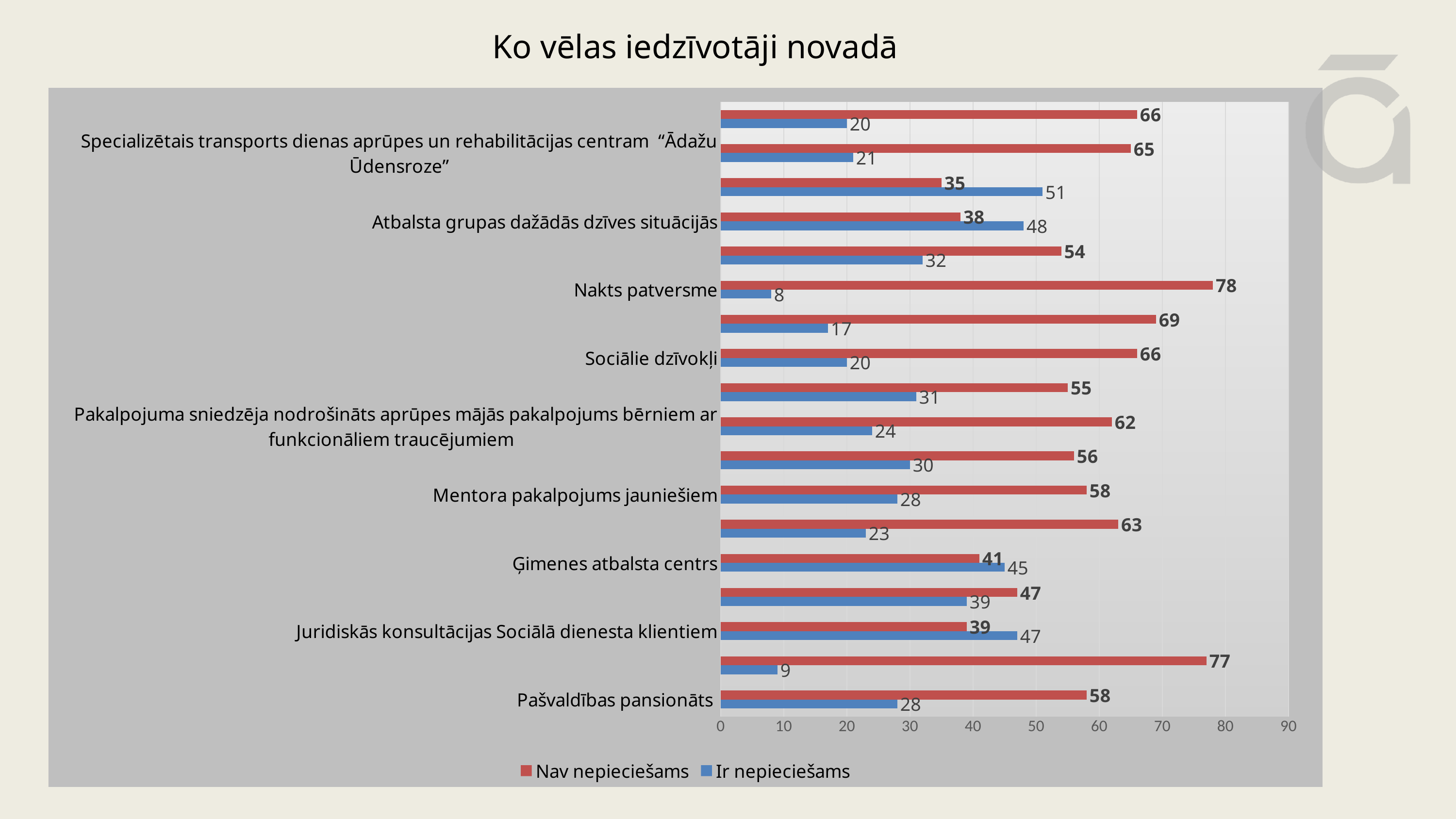
Which labelled category has the highest "Nav nepieciešams" value? Nakts patversme What is the value of "Nav nepieciešams" for Sociālie dzīvokļi? 66 What is the value of "Ir nepieciešams" for Atbalsta grupas dažādās dzīves situācijās? 48 Which labelled category has the lowest "Ir nepieciešams" value? Nakts patversme What is the difference between the "Nav nepieciešams" and "Ir nepieciešams" values for Ģimenes atbalsta centrs? 4 What is the value of "Ir nepieciešams" for Pašvaldības pansionāts? 28 What is the value of "Nav nepieciešams" for Nakts patversme? 78 For Juridiskās konsultācijas Sociālā dienesta klientiem, which is larger: "Nav nepieciešams" or "Ir nepieciešams"? Ir nepieciešams How many series does the legend list? 2 What kind of chart is shown on the slide? Bar chart What is the title of the chart? Ko vēlas iedzīvotāji novadā What is the value of "Ir nepieciešams" for Nakts patversme? 8